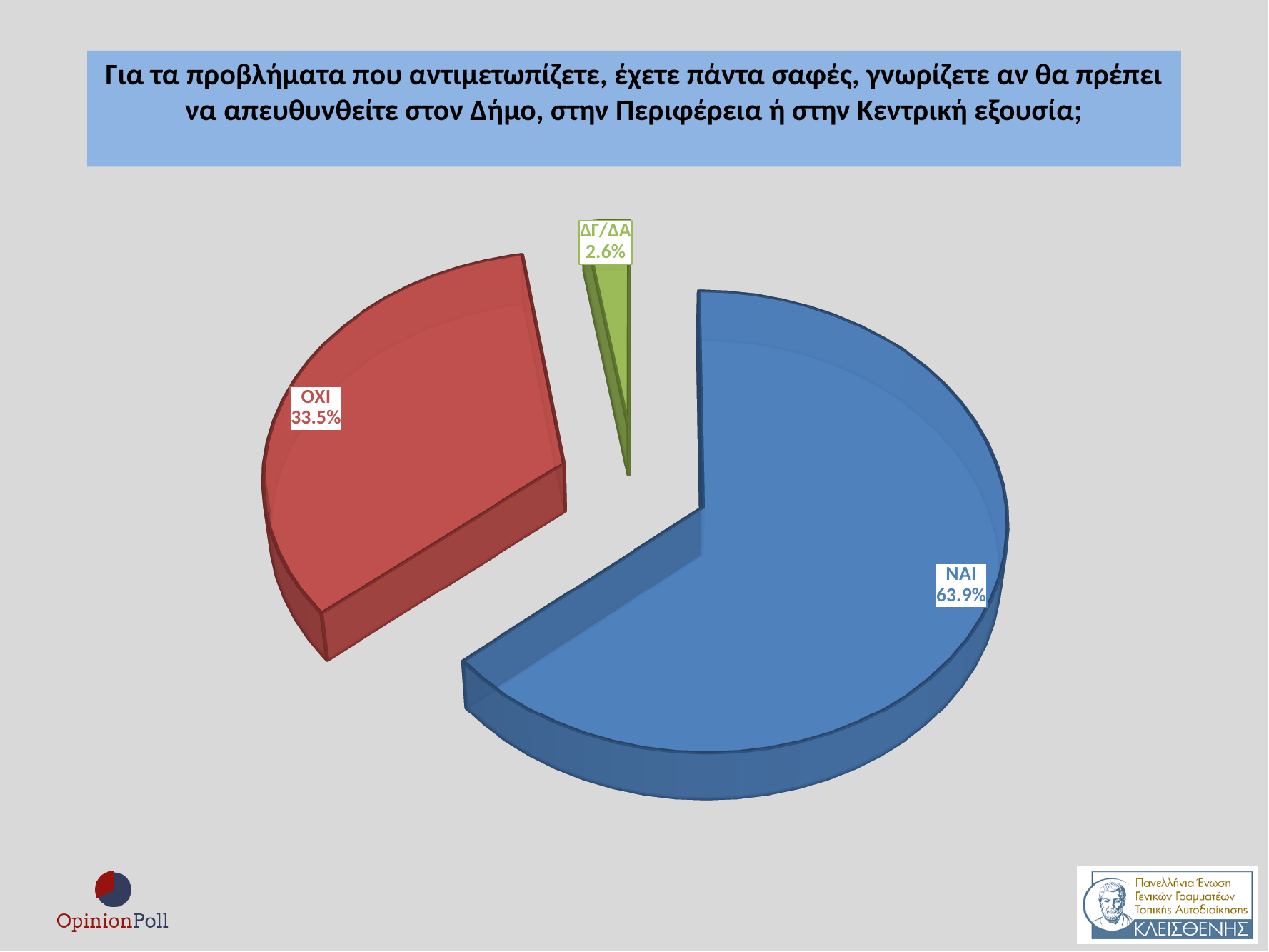
What percentage of respondents answered ΟΧΙ? 33.5% Which is larger, the share for ΟΧΙ or the share for ΔΓ/ΔΑ? ΟΧΙ What colour is the ΝΑΙ slice? Blue What percentage of respondents answered ΝΑΙ? 63.9% How many slices does the pie chart have? 3 What is the difference in percentage points between ΝΑΙ and ΟΧΙ? 30.4 What percentage of respondents answered ΔΓ/ΔΑ? 2.6% What kind of chart is shown on the slide? Pie chart What is the difference in percentage points between ΟΧΙ and ΔΓ/ΔΑ? 30.9 What colour is the ΟΧΙ slice? Red Which response has the largest share of the pie? ΝΑΙ Which response has the smallest share of the pie? ΔΓ/ΔΑ